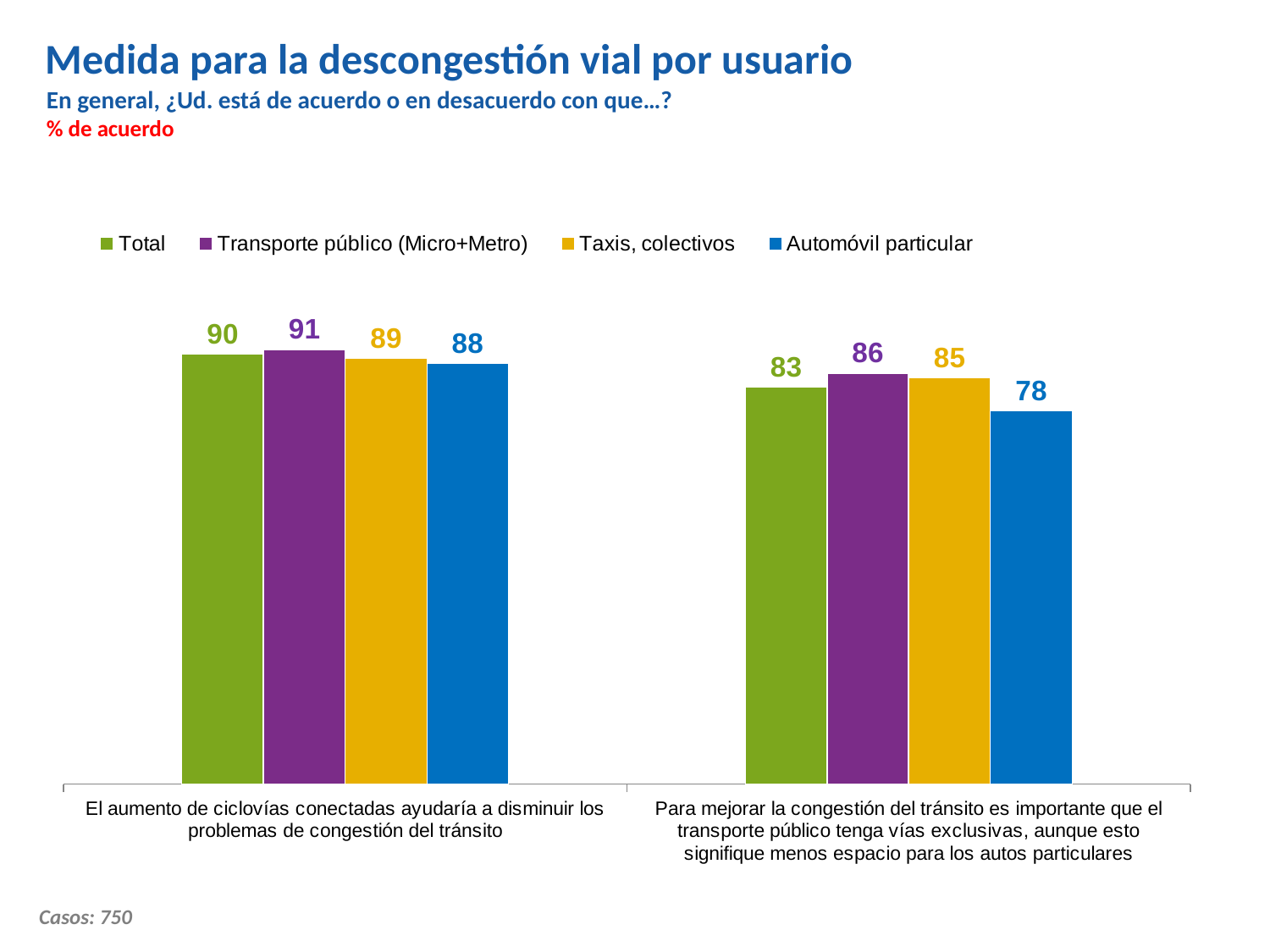
What colour represents Taxis, colectivos in the chart? Yellow What is the value for Transporte público (Micro+Metro) on the measure about connected bike lanes (ciclovías conectadas)? 91 Which is larger: the Automóvil particular value for the bike lanes measure or for the exclusive lanes measure? Bike lanes measure (88) Which user group has the lowest value on the measure about exclusive lanes for public transport? Automóvil particular What is the Total value for the measure about exclusive lanes for public transport? 83 What is the difference between the Transporte público (Micro+Metro) and Automóvil particular values on the measure about exclusive lanes for public transport? 8 What is the difference between the Total values for the two measures? 7 How many series does the legend list? 4 What is the value for Automóvil particular on the measure about exclusive lanes for public transport (vías exclusivas)? 78 What is the value for Taxis, colectivos on the measure about connected bike lanes? 89 What kind of chart is shown on the slide? Bar chart Which user group has the highest value on the measure about connected bike lanes? Transporte público (Micro+Metro)